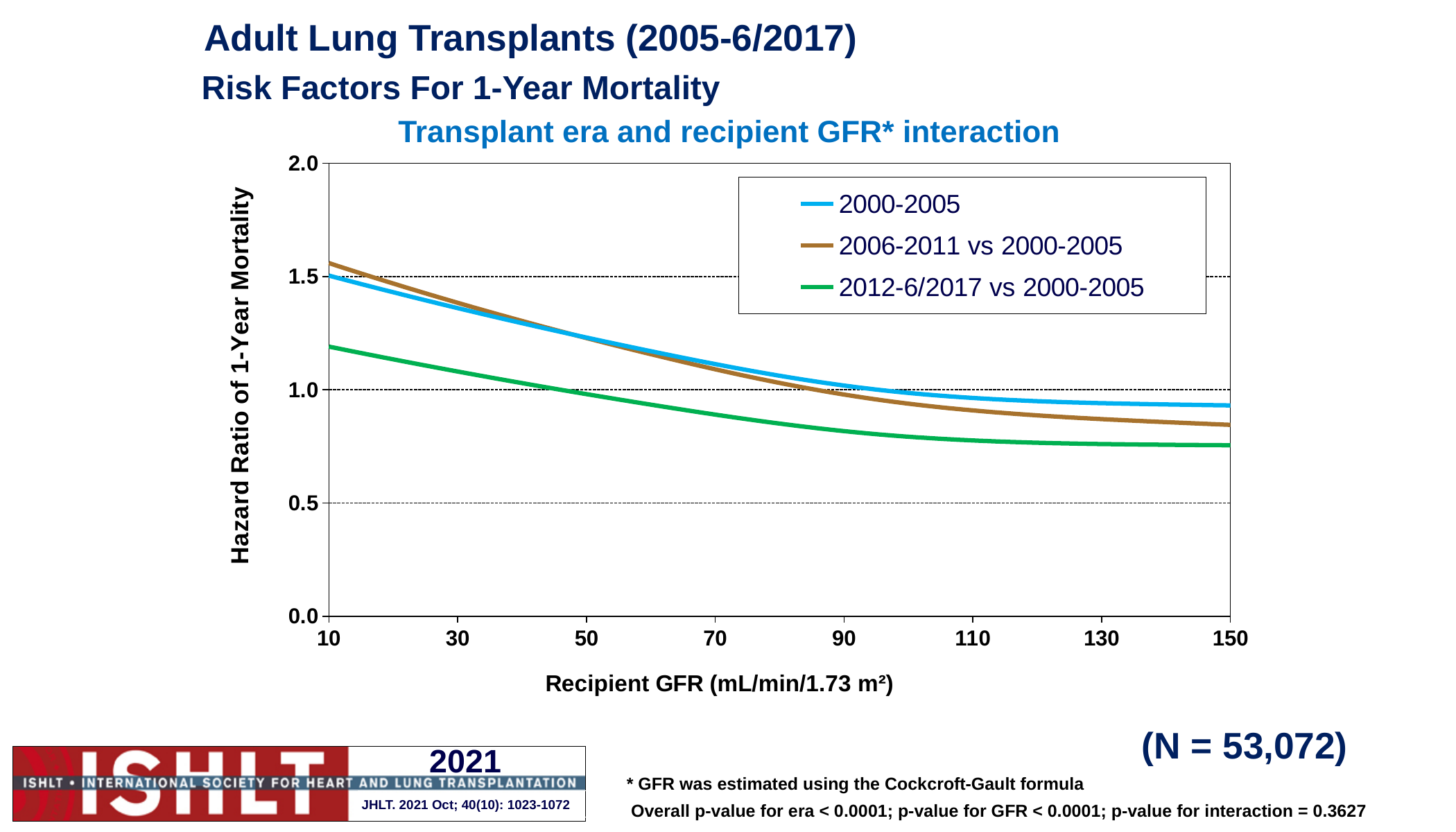
What is the label of the y-axis of the chart? Hazard Ratio of 1-Year Mortality How many series does the legend list? 3 Is the hazard ratio for the 2012-6/2017 vs 2000-2005 series at a GFR of 150 greater or less than 0.5? greater At a GFR of 10, which series has the higher hazard ratio: 2000-2005 or 2012-6/2017 vs 2000-2005? 2000-2005 Which colour represents the 2006-2011 vs 2000-2005 series in the legend? Brown Is the hazard ratio for the 2012-6/2017 vs 2000-2005 series at a GFR of 150 greater or less than 1.0? less At a GFR of 150, which series has the higher hazard ratio: 2006-2011 vs 2000-2005 or 2012-6/2017 vs 2000-2005? 2006-2011 vs 2000-2005 Does the hazard ratio for the 2000-2005 series rise or fall as recipient GFR increases? Fall Does the hazard ratio for the 2012-6/2017 vs 2000-2005 series rise or fall as recipient GFR increases? Fall Is the hazard ratio for the 2012-6/2017 vs 2000-2005 series at a GFR of 10 greater or less than 1.0? greater What kind of chart is shown on the slide? Line chart